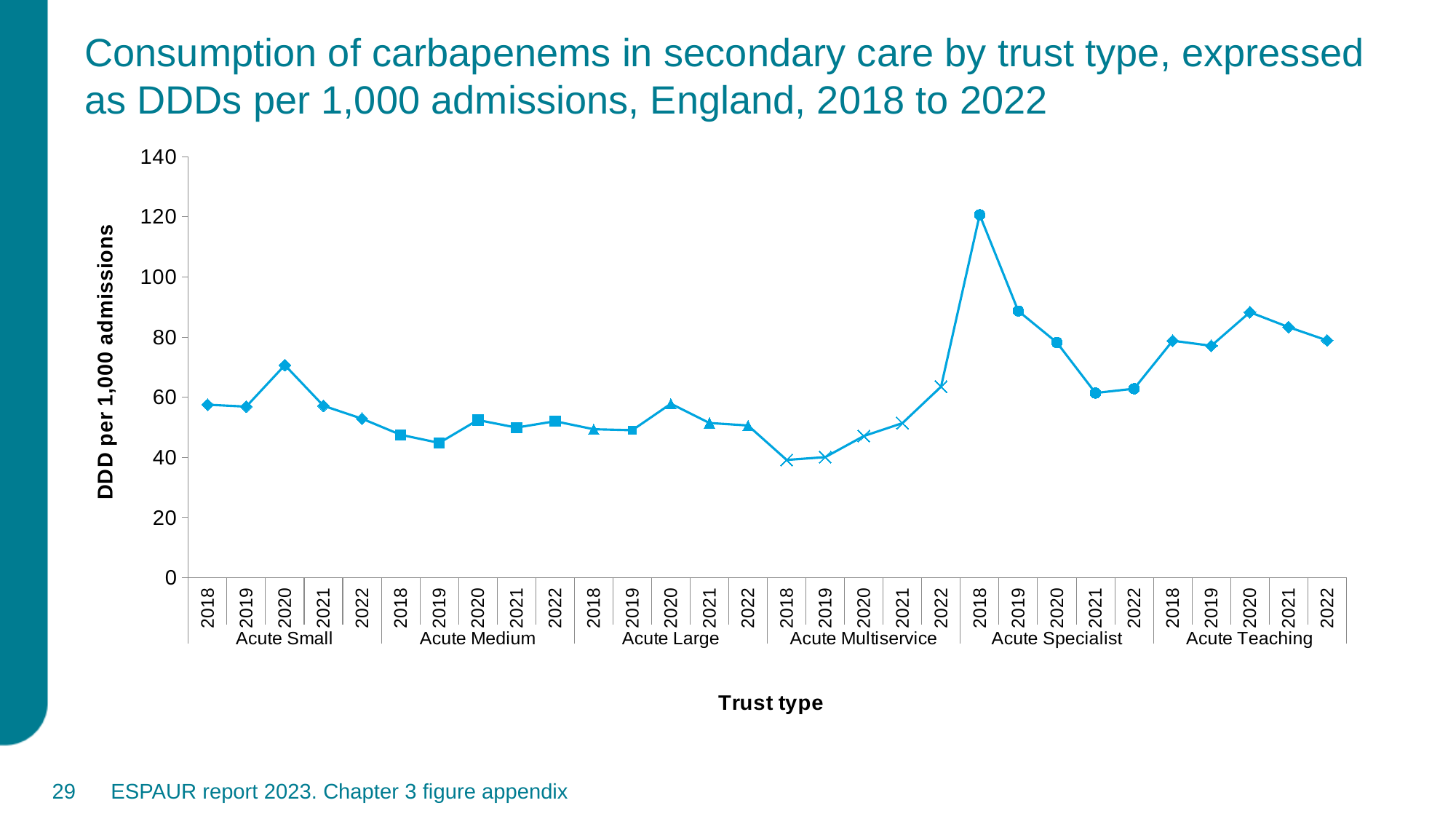
Is the value for Acute Specialist in 2018 greater or less than 100? greater How many trust types are shown on the x axis? 6 Is the value for Acute Medium in 2019 greater or less than 60? less Which trust type contains the lowest point on the chart? Acute Multiservice Is the value for Acute Teaching in 2020 greater or less than 80? greater Which trust type and year has the highest DDD per 1,000 admissions? Acute Specialist, 2018 What is the label of the y axis? DDD per 1,000 admissions Do the values for Acute Multiservice rise or fall from 2018 to 2022? rise Do the values for Acute Specialist rise or fall from 2018 to 2021? fall What kind of chart is shown on the slide? line chart Which is larger, the value for Acute Small in 2020 or Acute Medium in 2020? Acute Small in 2020 Which is larger, the value for Acute Specialist in 2018 or Acute Teaching in 2018? Acute Specialist in 2018